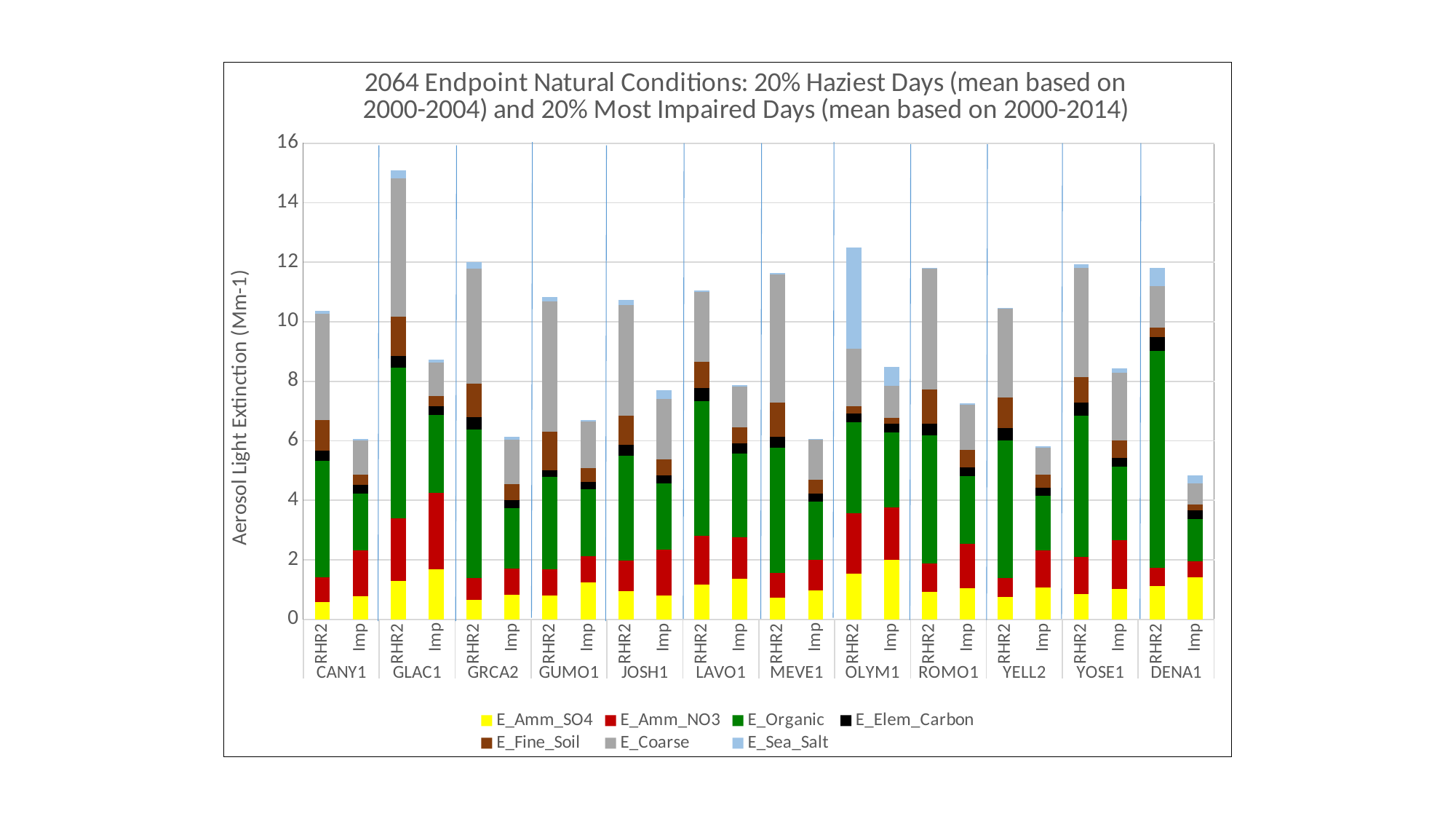
Is the total value for the DENA1 Imp bar greater or less than 6? less How many bars are plotted in total on the chart? 24 What is the label on the y axis? Aerosol Light Extinction (Mm-1) For OLYM1, which bar is taller, RHR2 or Imp? RHR2 How many series does the legend list? 7 Which bar has the lowest total aerosol light extinction? DENA1 Imp Is the total value for the MEVE1 RHR2 bar greater or less than 10? greater Is the total value for the OLYM1 RHR2 bar greater or less than 12? greater How many monitoring sites are shown along the x axis? 12 What kind of chart is shown on the slide? Stacked bar chart Which bar has the highest total aerosol light extinction? GLAC1 RHR2